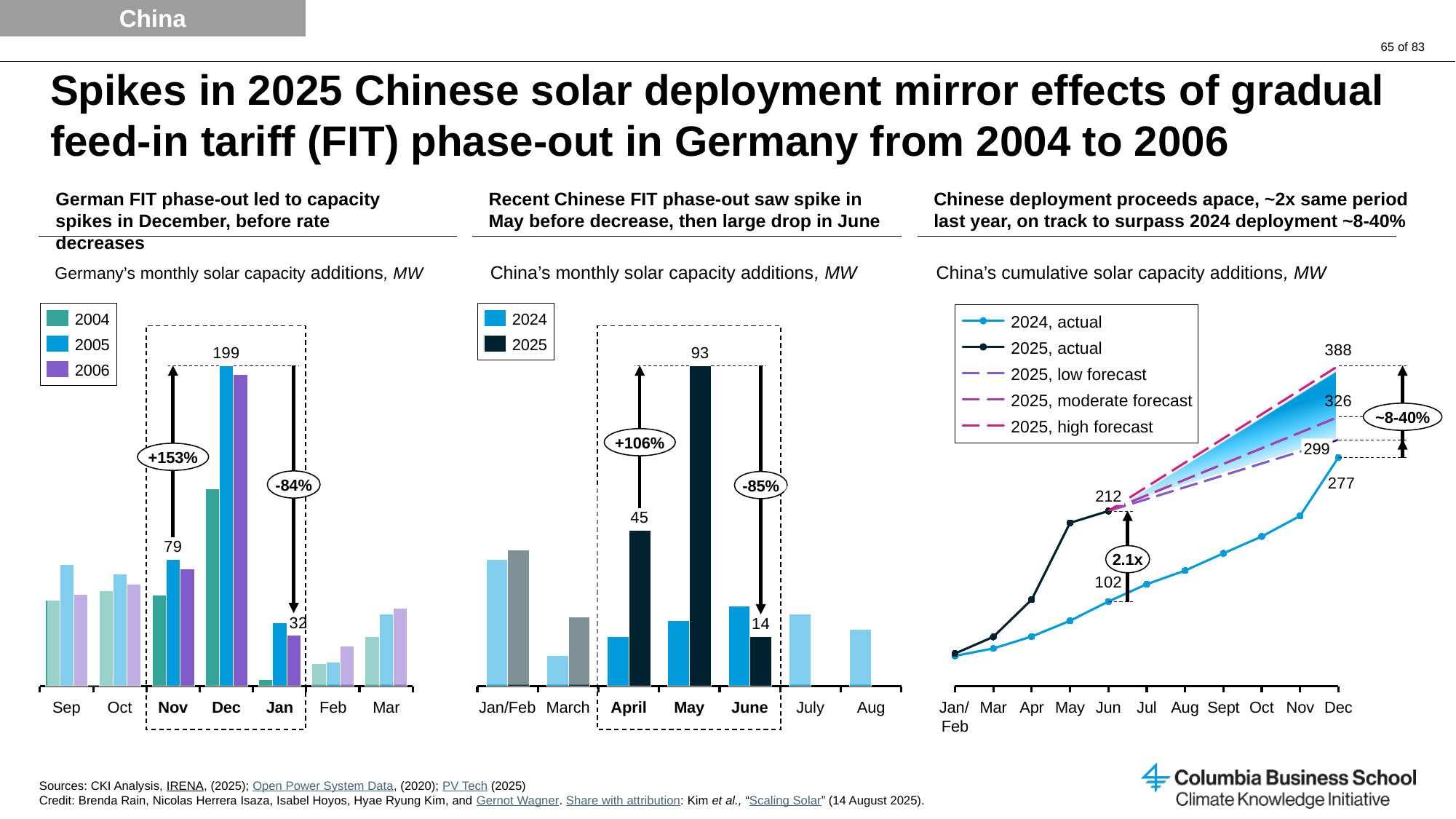
In the chart titled "China's monthly solar capacity additions, MW", which month has the highest 2025 value? May In the chart titled "Germany's monthly solar capacity additions, MW", what is the value for Dec in 2005? 199 In the chart titled "Germany's monthly solar capacity additions, MW", how many series does the legend list? 3 In the chart titled "China's cumulative solar capacity additions, MW", how many series does the legend list? 5 In the chart titled "China's cumulative solar capacity additions, MW", what is the 2025 high forecast value in Dec? 388 In the chart titled "China's monthly solar capacity additions, MW", what is the value for June in 2025? 14 What kind of chart is "China's monthly solar capacity additions, MW"? Bar chart In the chart titled "China's cumulative solar capacity additions, MW", what is the 2025 actual value in Jun? 212 In the chart titled "China's monthly solar capacity additions, MW", what is the difference between the May 2025 and April 2025 values? 48 In the chart titled "Germany's monthly solar capacity additions, MW", what is the difference between the Dec 2005 value and the Jan 2006 value? 167 In the chart titled "China's monthly solar capacity additions, MW", what is the value for May in 2025? 93 In the chart titled "Germany's monthly solar capacity additions, MW", how many months are shown on the x axis? 7